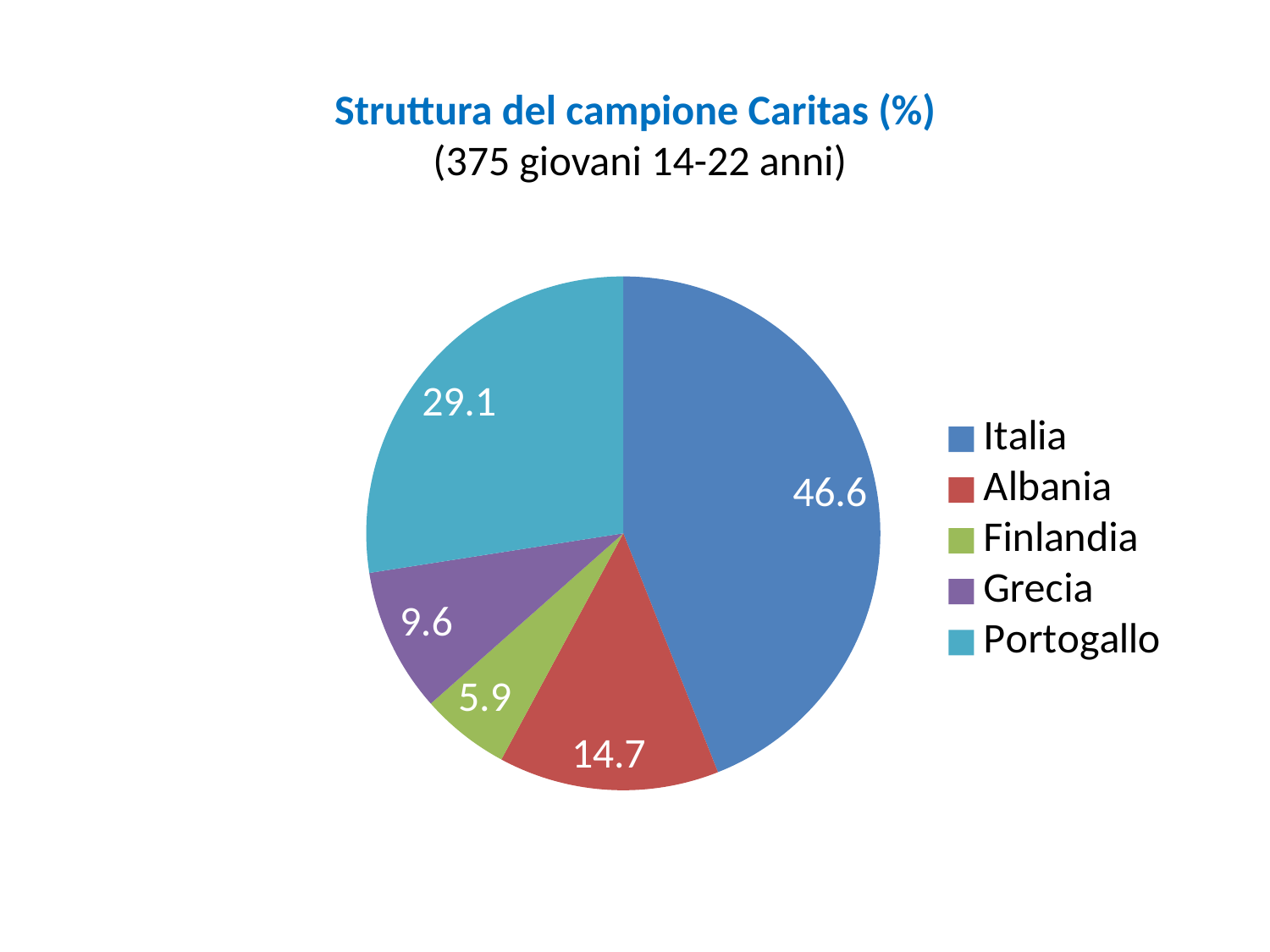
What is the difference between the values for Italia and Portogallo? 17.5 What is the title of the chart? Struttura del campione Caritas (%) What is the value for Portogallo? 29.1 How many slices does the pie chart have? 5 What is the value for Italia? 46.6 What kind of chart is shown on the slide? pie chart Which colour represents Grecia in the legend? purple Which is larger, the value for Grecia or the value for Albania? Albania What is the value for Albania? 14.7 What is the value for Finlandia? 5.9 Which country has the largest slice? Italia Which country has the smallest slice? Finlandia